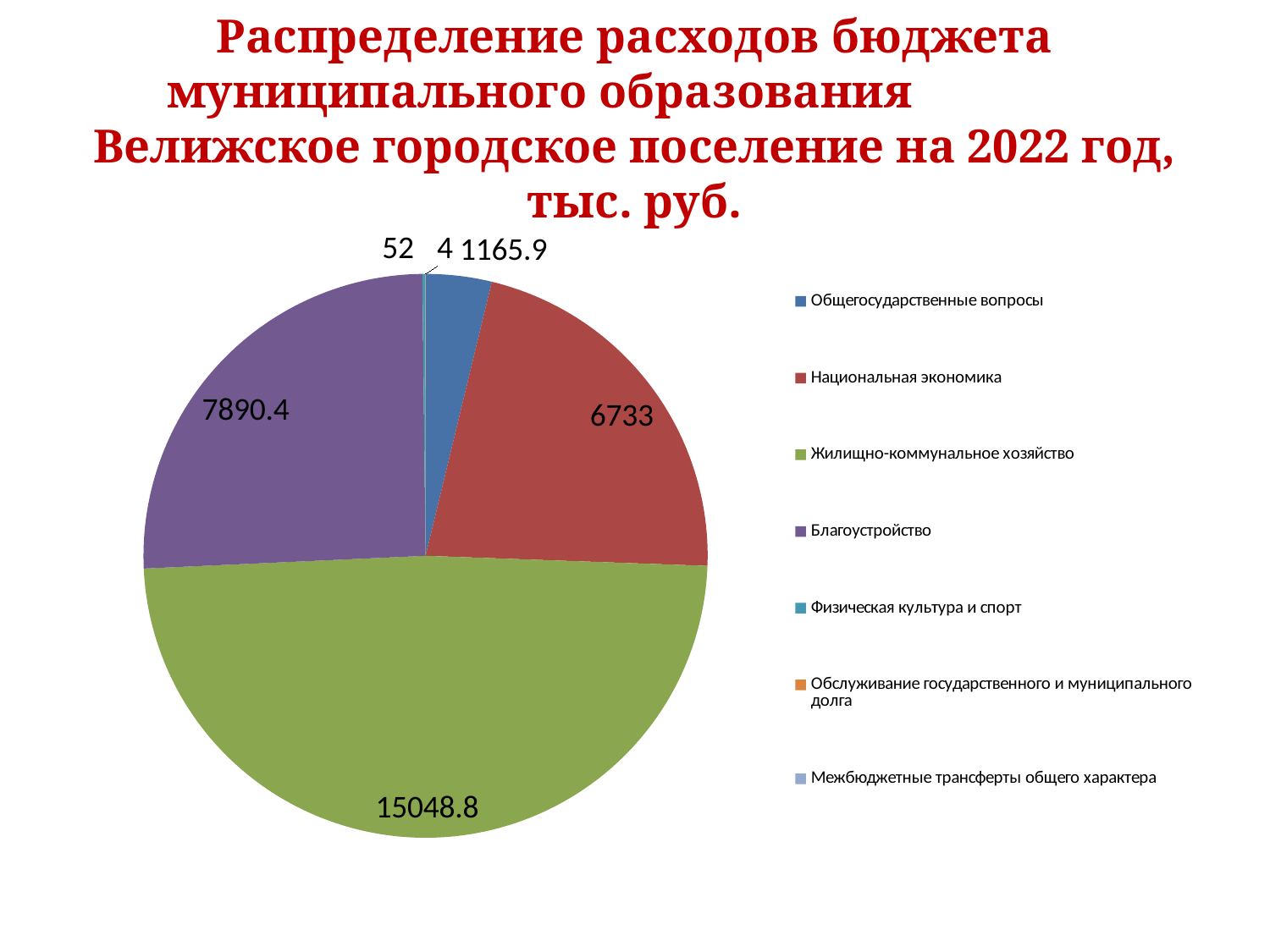
What is the difference between the values for Жилищно-коммунальное хозяйство and Благоустройство? 7158.4 Which is larger, Общегосударственные вопросы or Национальная экономика? Национальная экономика In what units are the values in the chart expressed, according to the title? тыс. руб. What is the value for Жилищно-коммунальное хозяйство? 15048.8 What is the value for Национальная экономика? 6733 What is the difference between the values for Благоустройство and Национальная экономика? 1157.4 Which category has the largest slice of the pie? Жилищно-коммунальное хозяйство What kind of chart is shown on the slide? pie chart Which is larger, Благоустройство or Национальная экономика? Благоустройство What is the value for Благоустройство? 7890.4 What is the value for Общегосударственные вопросы? 1165.9 How many categories does the legend of the pie chart list? 7